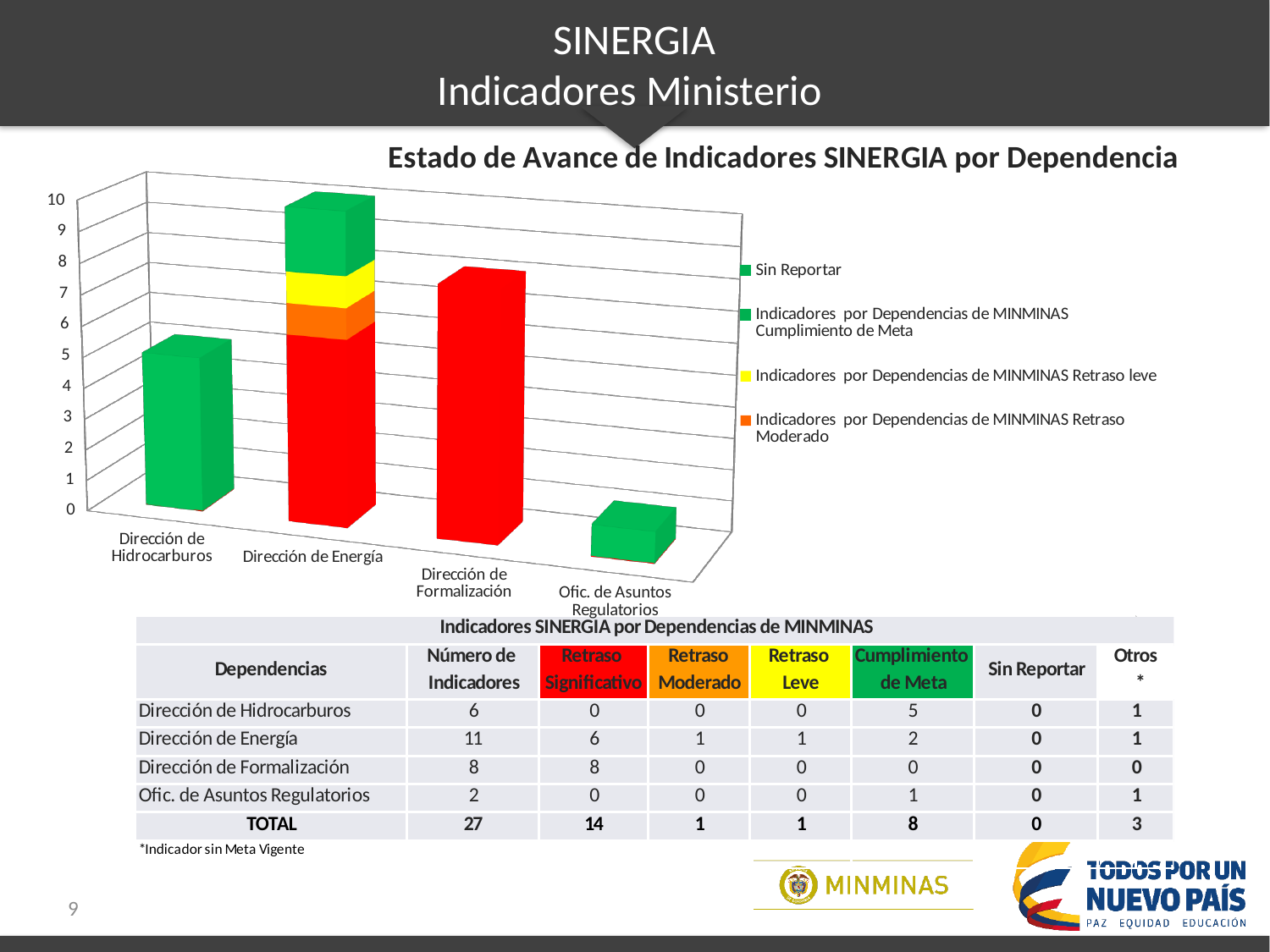
How many dependencias (categories) are shown on the x axis of the chart? 4 What kind of chart is shown on the slide? bar chart What colour represents 'Retraso leve' in the chart legend? yellow According to the table, what is the total number of indicators in Cumplimiento de Meta across all dependencias? 8 Is the bar for Dirección de Hidrocarburos greater or less than 3? greater According to the table, how many indicators does Dirección de Energía have in Retraso Significativo? 6 What is the title of the chart? Estado de Avance de Indicadores SINERGIA por Dependencia Is the bar for Ofic. de Asuntos Regulatorios greater or less than 3? less Which dependencia has the tallest bar in the chart? Dirección de Energía Which bar is taller, Dirección de Formalización or Dirección de Hidrocarburos? Dirección de Formalización Which dependencia has the shortest bar in the chart? Ofic. de Asuntos Regulatorios Is the bar for Dirección de Formalización greater or less than 5? greater